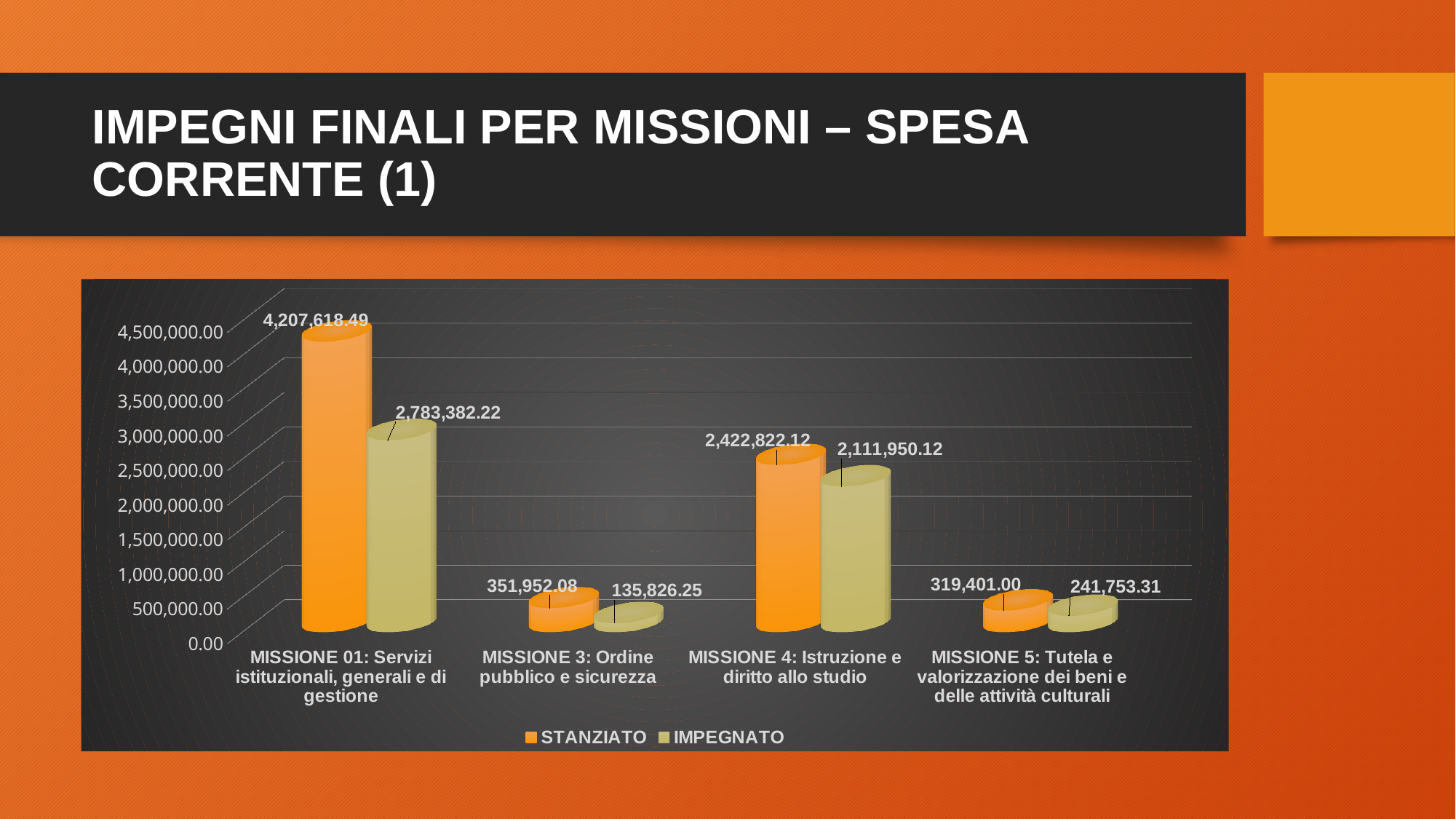
Which mission has the highest STANZIATO value? MISSIONE 01: Servizi istituzionali, generali e di gestione What is the STANZIATO value for MISSIONE 01: Servizi istituzionali, generali e di gestione? 4,207,618.49 Which mission has the lowest IMPEGNATO value? MISSIONE 3: Ordine pubblico e sicurezza What is the difference between the STANZIATO and IMPEGNATO values for MISSIONE 01: Servizi istituzionali, generali e di gestione? 1,424,236.27 What kind of chart is shown on the slide? Bar chart What is the difference between the STANZIATO and IMPEGNATO values for MISSIONE 4: Istruzione e diritto allo studio? 310,872.00 What is the IMPEGNATO value for MISSIONE 3: Ordine pubblico e sicurezza? 135,826.25 How many series does the legend list? 2 What is the STANZIATO value for MISSIONE 5: Tutela e valorizzazione dei beni e delle attività culturali? 319,401.00 What is the IMPEGNATO value for MISSIONE 4: Istruzione e diritto allo studio? 2,111,950.12 Which is larger: the STANZIATO value for MISSIONE 3 or the STANZIATO value for MISSIONE 5? MISSIONE 3 How many missions (categories) are shown on the x axis? 4